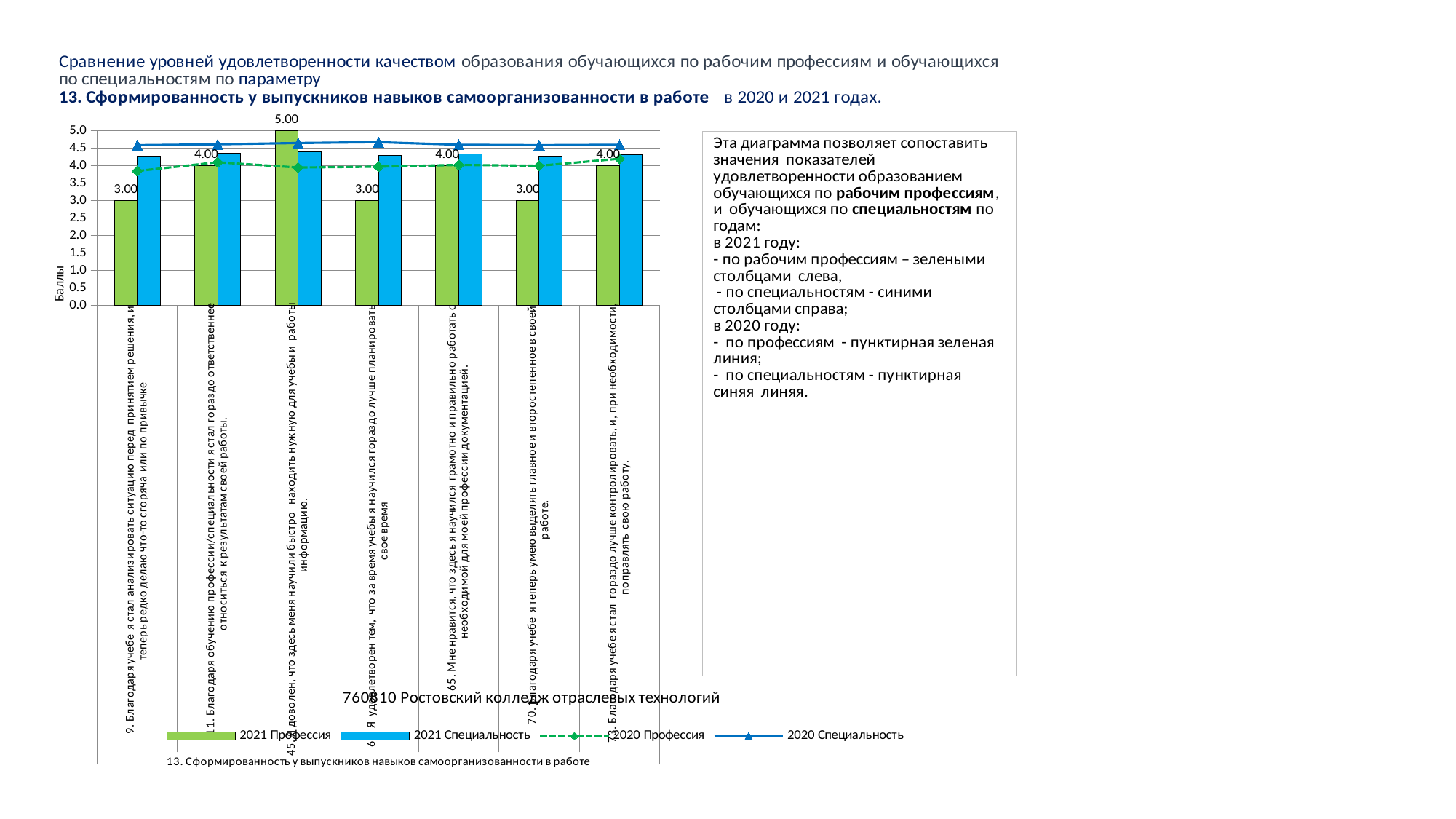
What kind of chart is shown on the slide? A combined bar and line chart What is the 2021 Профессия value for the category "70. Благодаря учебе я теперь умею выделять главное и второстепенное в своей работе"? 3.00 How many categories are shown on the x axis of the chart? 7 What is the 2021 Профессия value for the category "11. Благодаря обучению профессии/специальности я стал гораздо ответственнее относиться к результатам своей работы"? 4.00 How many series does the legend list? 4 What is the 2021 Профессия value for the category "45. Я доволен, что здесь меня научили быстро находить нужную для учебы и работы информацию"? 5.00 Which category has the highest 2021 Профессия value? 45. Я доволен, что здесь меня научили быстро находить нужную для учебы и работы информацию How many categories have a 2021 Профессия value of 3.00? 3 What is the title of the vertical axis of the chart? Баллы For the category "9. Благодаря учебе я стал анализировать ситуацию перед принятием решения...", which is larger: the 2021 Профессия bar or the 2021 Специальность bar? 2021 Специальность What is the difference between the 2021 Профессия values for category 45 ("Я доволен, что здесь меня научили быстро находить нужную...") and category 9 ("Благодаря учебе я стал анализировать ситуацию...")? 2.00 Is the 2021 Специальность value for the category "9. Благодаря учебе я стал анализировать ситуацию перед принятием решения..." greater or less than 4.0? greater